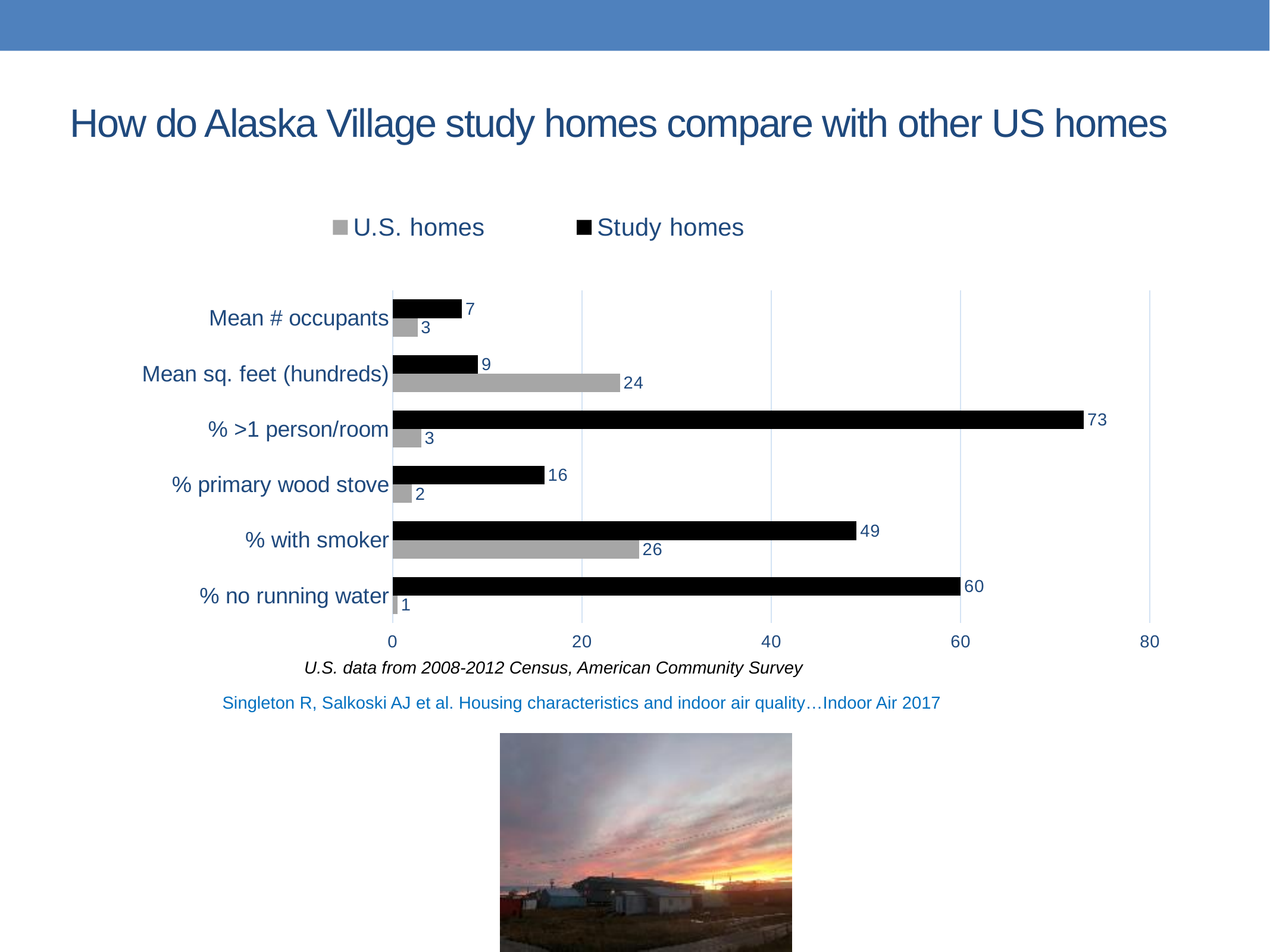
What is the value for Study homes in the "% no running water" category? 60 Which is larger for "Mean sq. feet (hundreds)": U.S. homes or Study homes? U.S. homes What colour are the bars for Study homes? Black What is the value for Study homes in the "% >1 person/room" category? 73 How many series does the legend list? 2 Which category has the lowest value for U.S. homes? % no running water What is the value for U.S. homes in the "% with smoker" category? 26 What is the value for U.S. homes in the "Mean sq. feet (hundreds)" category? 24 What is the difference between the Study homes and U.S. homes values for "% with smoker"? 23 Which category has the highest value for Study homes? % >1 person/room What kind of chart is shown on the slide? Bar chart How many categories are shown on the chart? 6